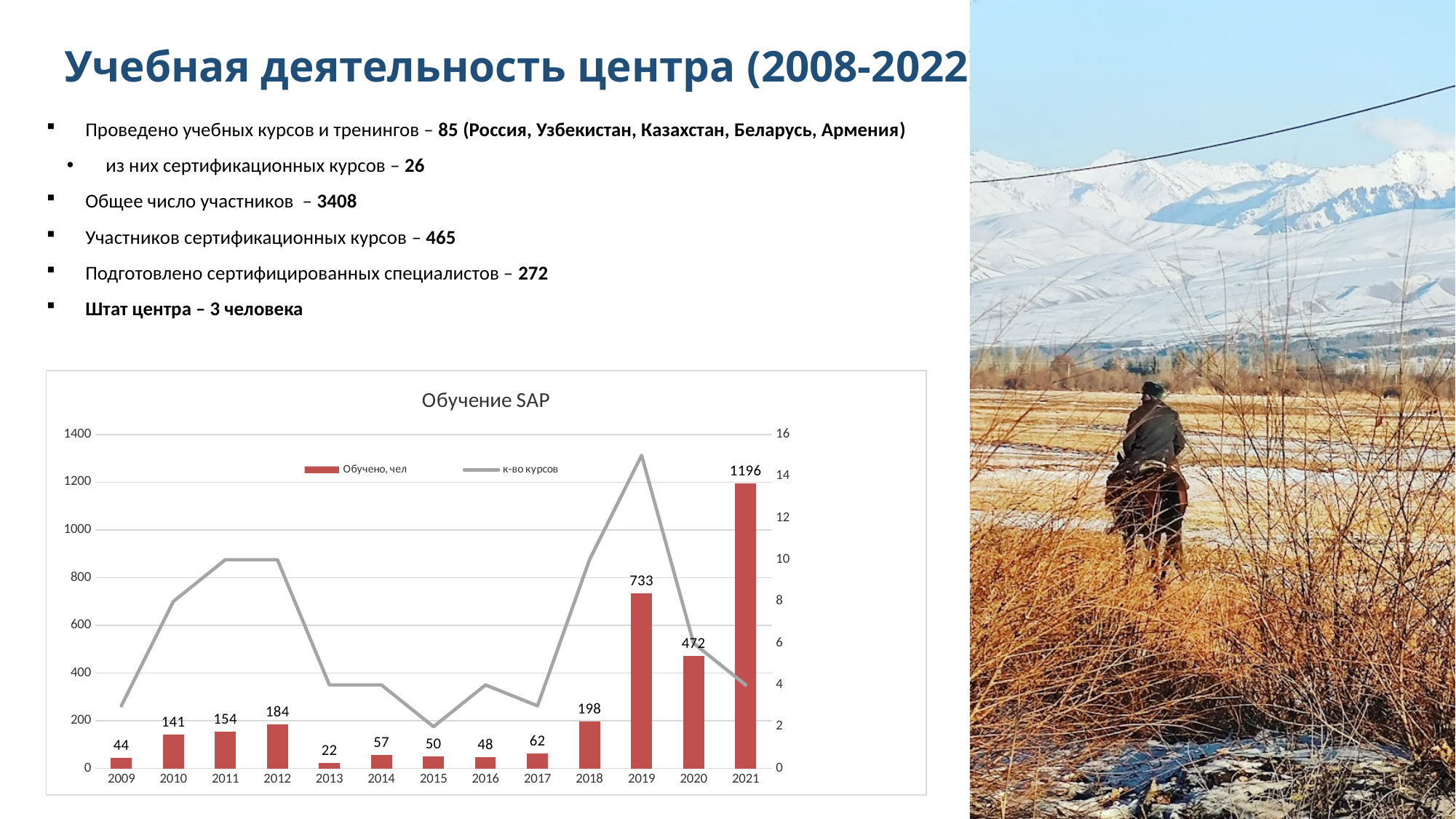
Which year has the highest value of "Обучено, чел"? 2021 Is the value of "к-во курсов" for 2019 greater or less than 12? greater What is the value of "Обучено, чел" for 2013? 22 Which year has the lowest value of "Обучено, чел"? 2013 What is the value of "Обучено, чел" for 2021? 1196 Which year has a larger "Обучено, чел" value, 2012 or 2018? 2018 What is the difference between the "Обучено, чел" values for 2021 and 2020? 724 What is the value of "Обучено, чел" for 2019? 733 Is the value of "к-во курсов" for 2015 greater or less than 4? less What is the title of the chart? Обучение SAP How many years are shown on the x axis of the chart? 13 How many series does the chart legend list? 2